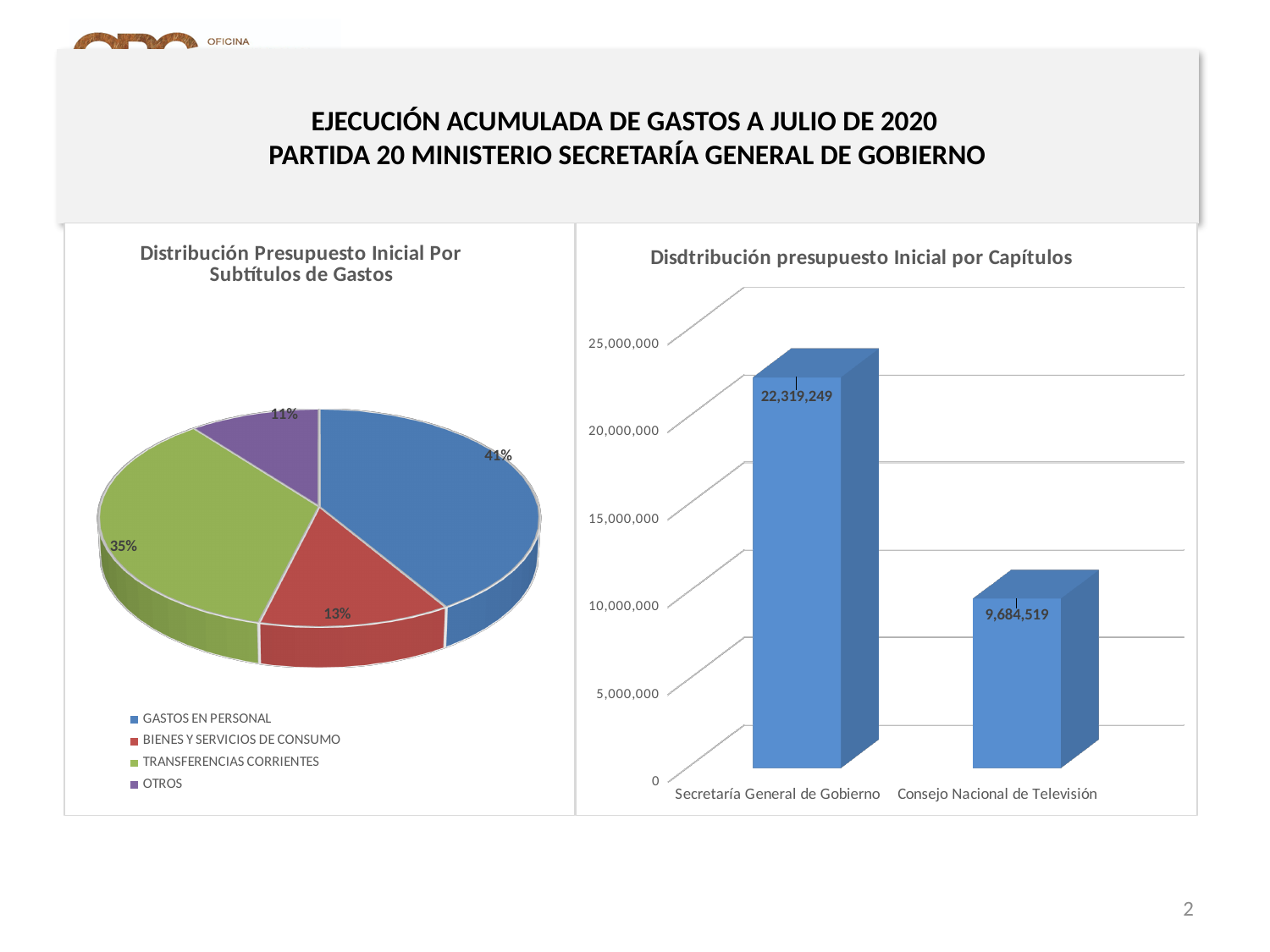
What kind of chart is 'Disdtribución presupuesto Inicial por Capítulos'? Bar chart In the pie chart 'Distribución Presupuesto Inicial Por Subtítulos de Gastos', what is the difference in percentage points between GASTOS EN PERSONAL and OTROS? 30 percentage points In the chart 'Disdtribución presupuesto Inicial por Capítulos', what is the value for Consejo Nacional de Televisión? 9,684,519 In the chart 'Disdtribución presupuesto Inicial por Capítulos', is the value for Consejo Nacional de Televisión greater or less than 10,000,000? less In the pie chart 'Distribución Presupuesto Inicial Por Subtítulos de Gastos', what share does BIENES Y SERVICIOS DE CONSUMO have? 13% In the chart 'Disdtribución presupuesto Inicial por Capítulos', what is the value for Secretaría General de Gobierno? 22,319,249 In the chart 'Disdtribución presupuesto Inicial por Capítulos', what is the difference between Secretaría General de Gobierno and Consejo Nacional de Televisión? 12,634,730 In the pie chart 'Distribución Presupuesto Inicial Por Subtítulos de Gastos', which category has the smallest share? OTROS In the pie chart 'Distribución Presupuesto Inicial Por Subtítulos de Gastos', how many categories does the legend list? 4 In the pie chart 'Distribución Presupuesto Inicial Por Subtítulos de Gastos', what share does GASTOS EN PERSONAL have? 41% In the pie chart 'Distribución Presupuesto Inicial Por Subtítulos de Gastos', what share does TRANSFERENCIAS CORRIENTES have? 35% In the pie chart 'Distribución Presupuesto Inicial Por Subtítulos de Gastos', which category has the largest share? GASTOS EN PERSONAL